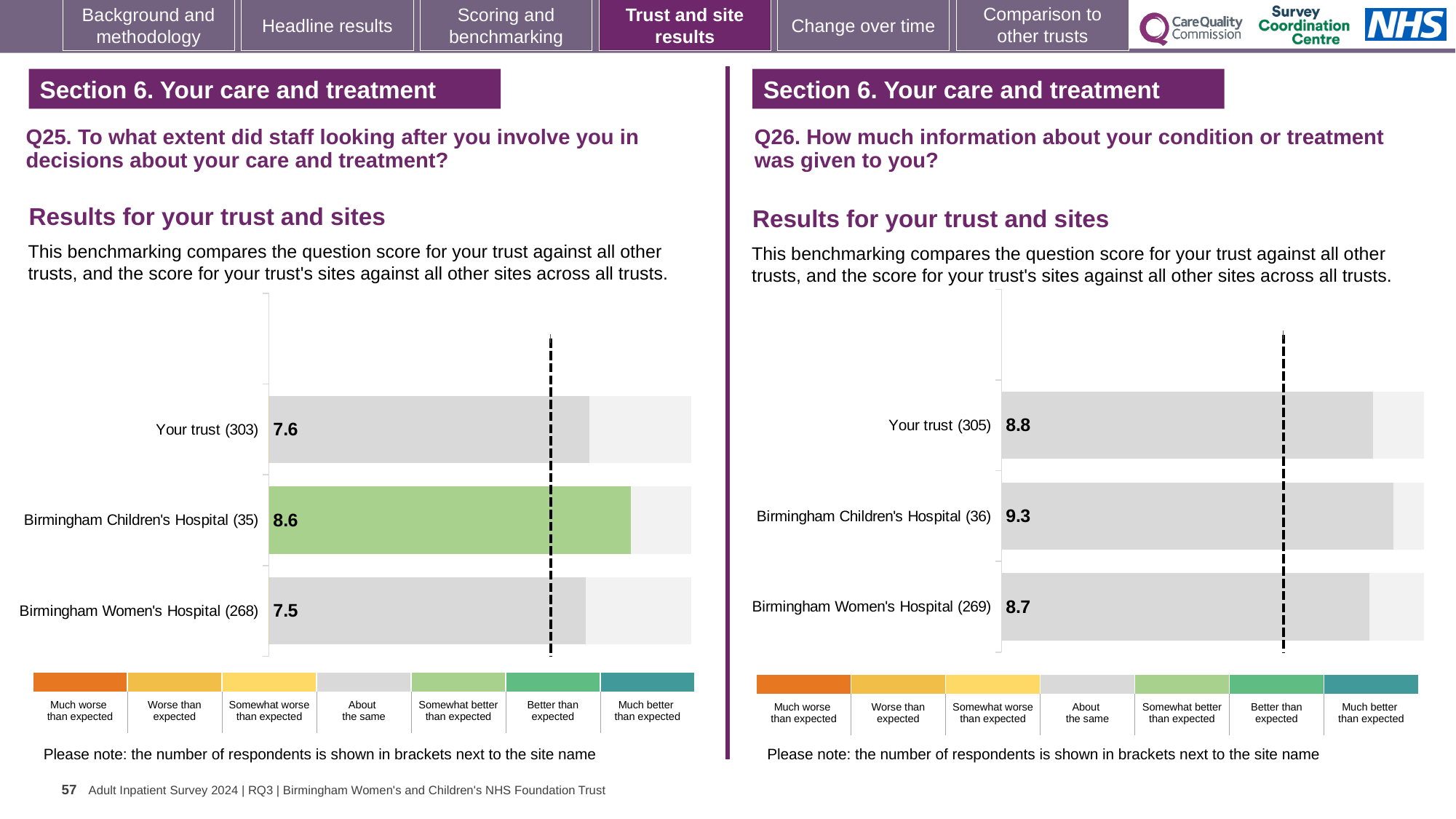
In the Q26 chart on the right, what is the difference between the scores for Birmingham Children's Hospital and Your trust? 0.5 How many bars are plotted in the Q26 chart on the right? 3 In the Q25 chart on the left, what is the score for Your trust? 7.6 In the Q25 chart on the left, what is the difference between the scores for Birmingham Children's Hospital and Birmingham Women's Hospital? 1.1 In the Q25 chart on the left, what is the score for Birmingham Children's Hospital? 8.6 What type of chart is used in the Q25 chart on the left? Bar chart In the Q26 chart on the right, what is the score for Birmingham Women's Hospital? 8.7 In the Q26 chart on the right, which site or trust has the lowest score? Birmingham Women's Hospital In the Q26 chart on the right, what is the score for Birmingham Children's Hospital? 9.3 In the Q25 chart on the left, which site or trust has the highest score? Birmingham Children's Hospital In the Q25 chart on the left, which benchmark category does the green bar for Birmingham Children's Hospital represent according to the legend? Somewhat better than expected In the Q25 chart on the left, which has the larger score: Your trust or Birmingham Children's Hospital? Birmingham Children's Hospital